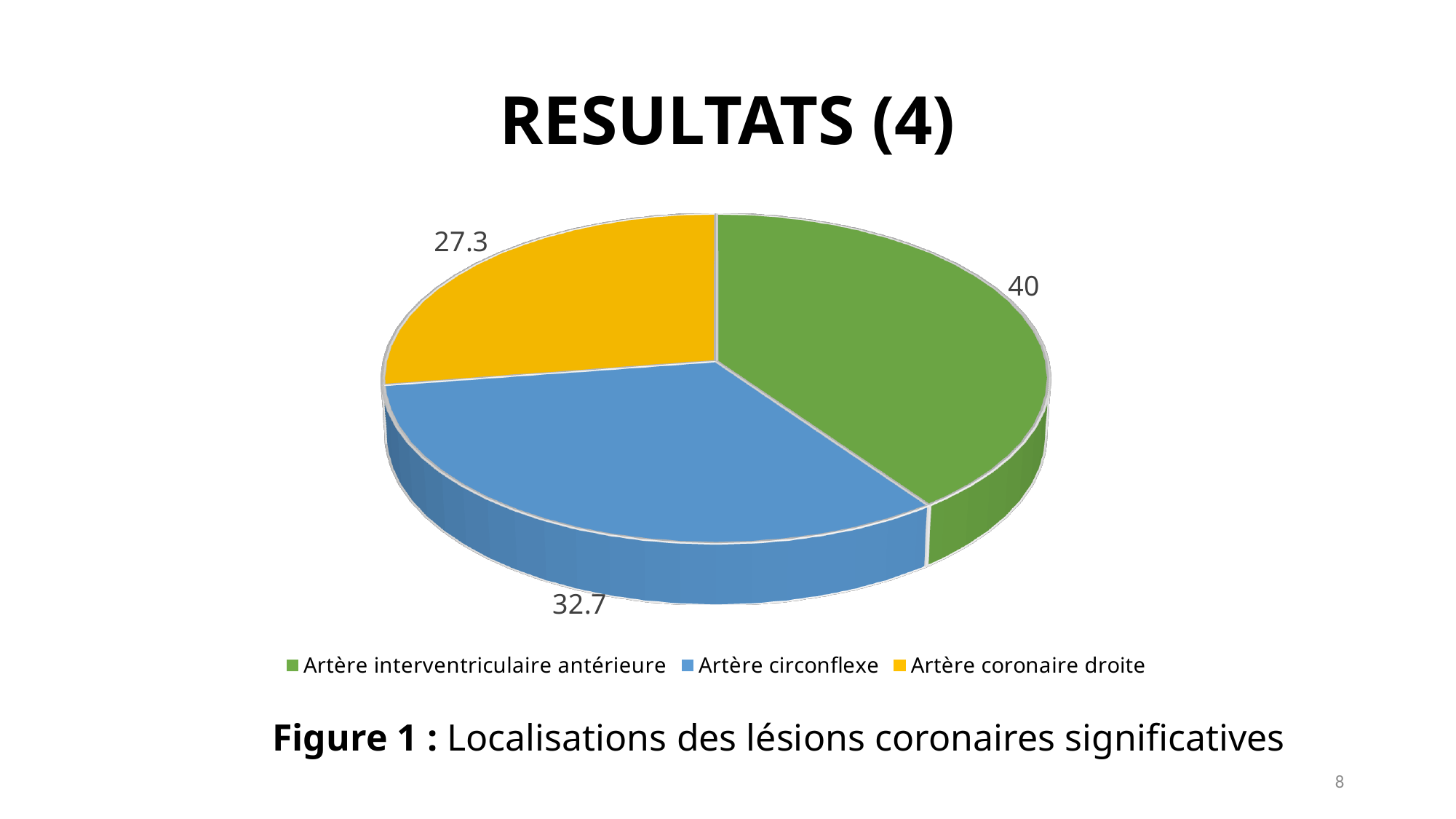
How many slices does the pie chart have? 3 Which category has the largest slice of the pie? Artère interventriculaire antérieure What value is shown for Artère circonflexe? 32.7 What is the caption of the figure below the chart? Figure 1 : Localisations des lésions coronaires significatives What kind of chart is shown on the slide? Pie chart What value is shown for Artère interventriculaire antérieure? 40 Which is larger, the value for Artère circonflexe or the value for Artère coronaire droite? Artère circonflexe What is the difference between the values for Artère circonflexe and Artère coronaire droite? 5.4 Which category has the smallest slice of the pie? Artère coronaire droite What is the difference between the values for Artère interventriculaire antérieure and Artère coronaire droite? 12.7 What colour is the slice for Artère circonflexe? Blue What value is shown for Artère coronaire droite? 27.3